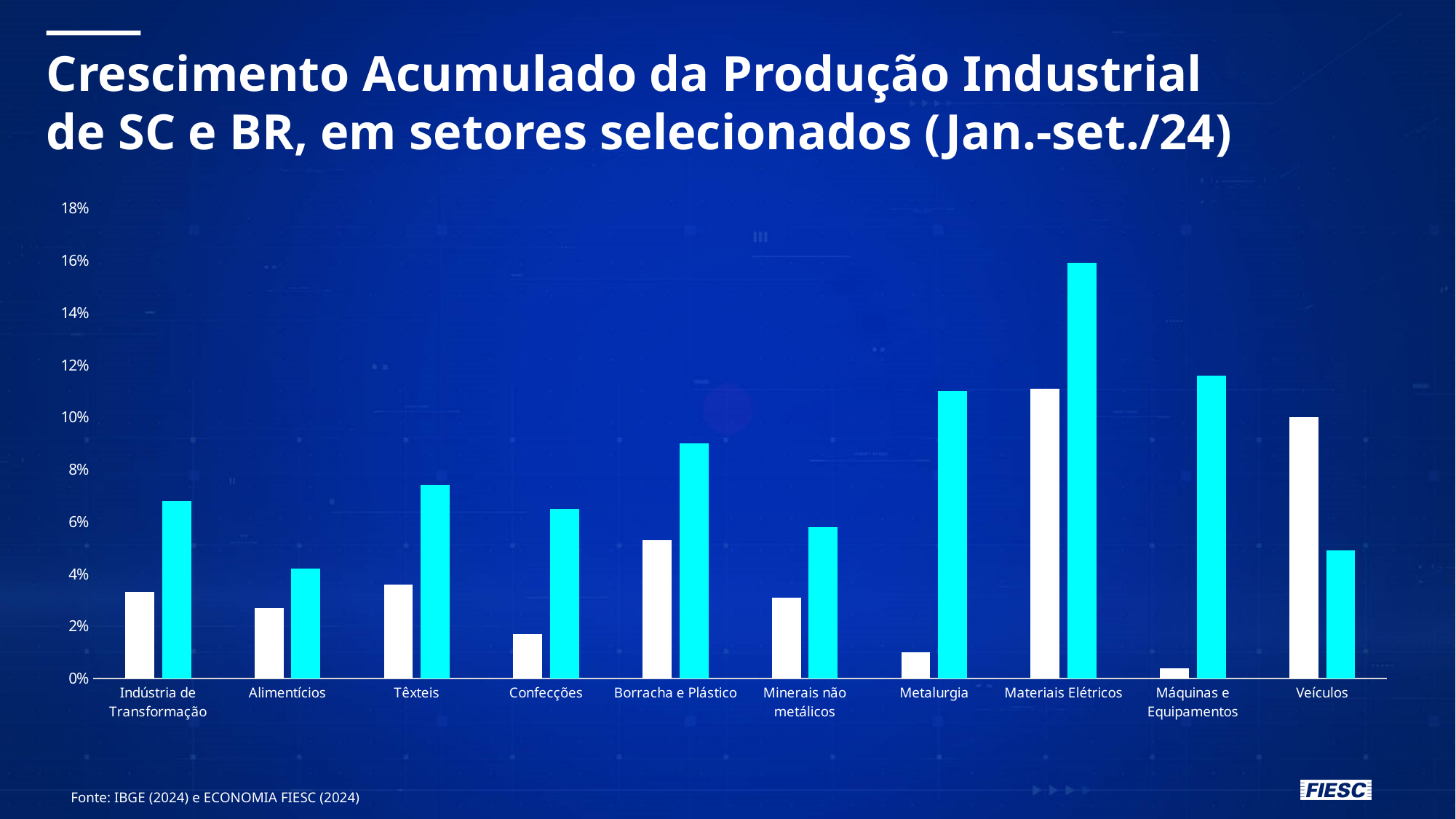
Is the white bar for Veículos greater or less than 8%? greater What period does the chart title say the data covers? Jan.-set./24 How many sectors (categories) are shown on the x axis of the chart? 10 Is the cyan bar for Materiais Elétricos greater or less than 14%? greater Is the cyan bar for Metalurgia greater or less than 10%? greater What kind of chart is shown on the slide? bar chart For Veículos, which bar is taller, the white bar or the cyan bar? the white bar Which sector has the tallest white bar? Materiais Elétricos Which sector has the shortest white bar? Máquinas e Equipamentos Which sector has the shortest cyan bar? Alimentícios Which sector has the tallest cyan bar? Materiais Elétricos